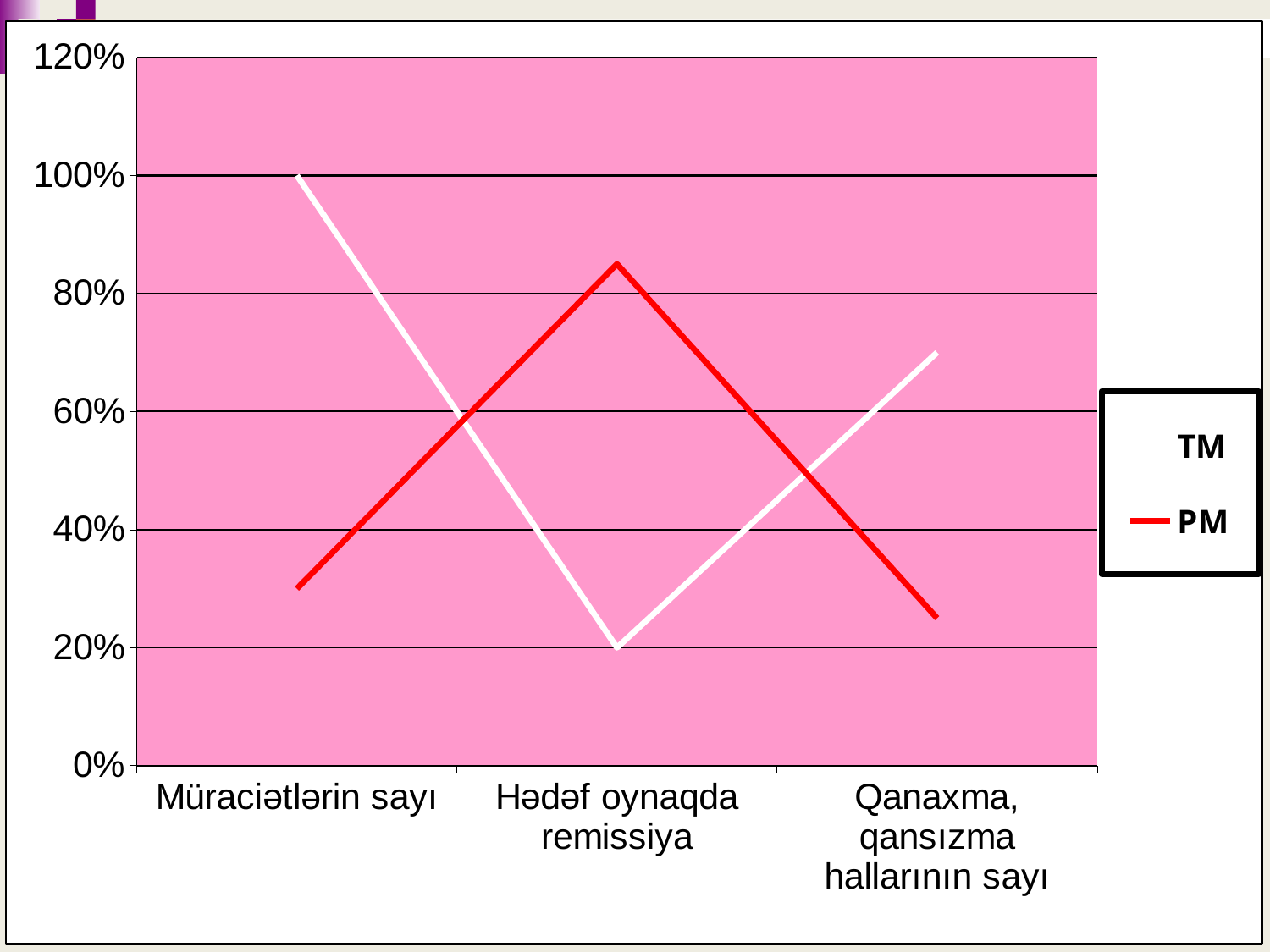
What colour is the PM line? red Is the value of PM for Hədəf oynaqda remissiya greater or less than 80%? greater Is the value of PM for Müraciətlərin sayı greater or less than 40%? less What is the value of TM for Hədəf oynaqda remissiya? 20% For which category is the PM series highest? Hədəf oynaqda remissiya For which category is the TM series highest? Müraciətlərin sayı What is the value of TM for Müraciətlərin sayı? 100% What kind of chart is shown on the slide? line chart How many series does the legend list? 2 Is the value of TM for Qanaxma, qansızma hallarının sayı greater or less than 60%? greater At Hədəf oynaqda remissiya, which series has the higher value, TM or PM? PM How many categories are shown on the x axis? 3